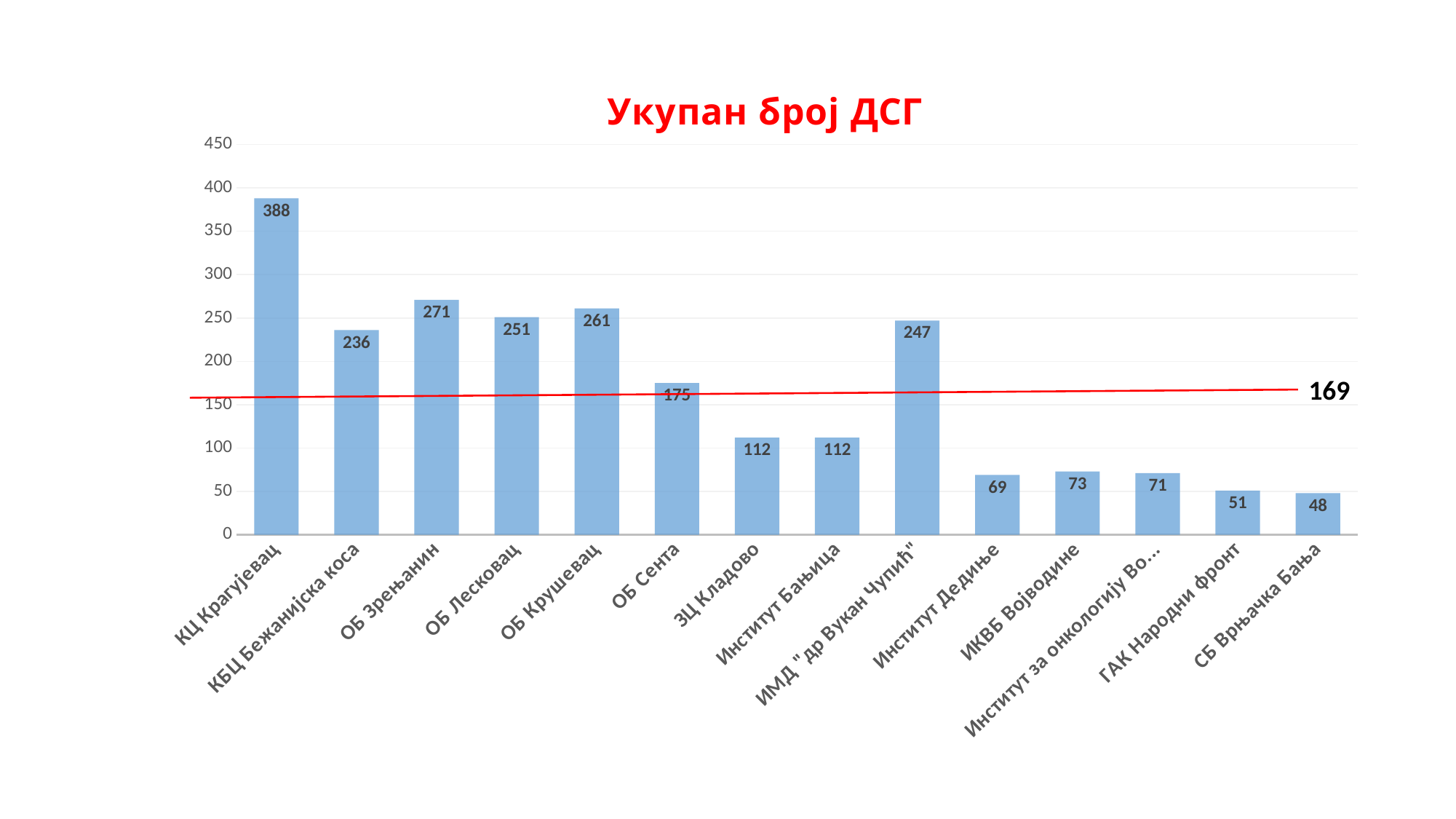
What is the value for ИМД "др Вукан Чупић"? 247 How many categories are shown on the x axis? 14 What is the difference between the values for ОБ Зрењанин and ОБ Лесковац? 20 Which category has the highest value? КЦ Крагујевац Which is larger, the value for ОБ Крушевац or the value for КБЦ Бежанијска коса? ОБ Крушевац What kind of chart is this? bar chart Is the value for ГАК Народни фронт greater or less than 100? less What is the title of the chart? Укупан број ДСГ Which category has the lowest value? СБ Врњачка Бања What value is labelled on the red horizontal line? 169 What is the value for ОБ Сента? 175 What is the value for КЦ Крагујевац? 388